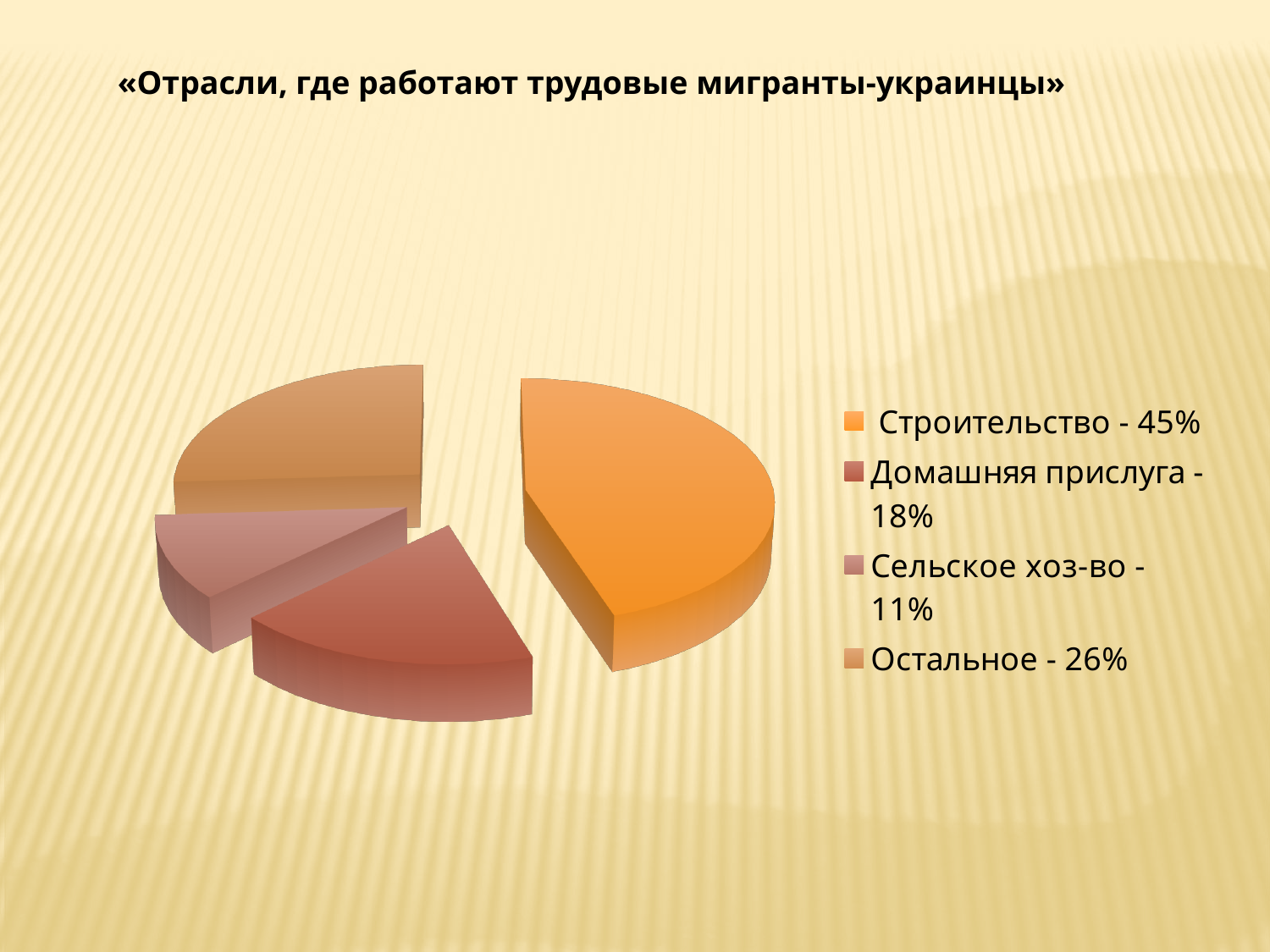
Which is larger, the share of Остальное or the share of Домашняя прислуга? Остальное What is the title of the slide? «Отрасли, где работают трудовые мигранты-украинцы» Which category has the largest share of the pie? Строительство What kind of chart is shown on the slide? Pie chart How many categories does the pie chart have? 4 What share of the pie does Строительство represent? 45% Which category has the smallest share of the pie? Сельское хоз-во What share of the pie does Сельское хоз-во represent? 11% What share of the pie does Остальное represent? 26% What is the difference between the shares of Домашняя прислуга and Сельское хоз-во? 7% What is the difference between the shares of Строительство and Остальное? 19%